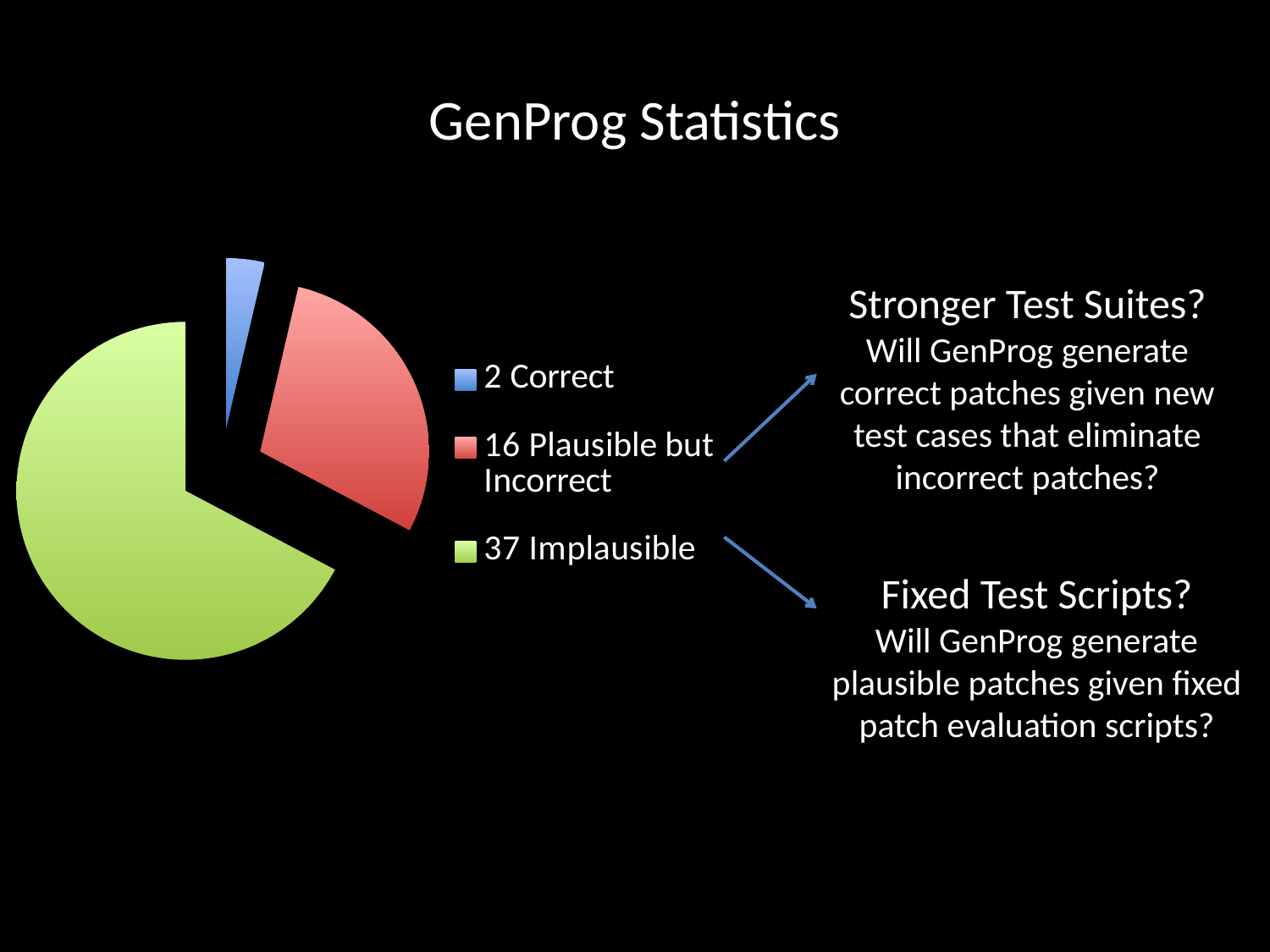
Which category has the largest slice of the pie chart? Implausible How many patches are labelled Plausible but Incorrect in the pie chart legend? 16 Which is larger, the number of Plausible but Incorrect patches or the number of Correct patches? Plausible but Incorrect How many entries does the legend of the pie chart list? 3 How many slices does the pie chart have? 3 What is the difference between the number of Implausible patches and the number of Plausible but Incorrect patches? 21 What kind of chart is shown on the slide? pie chart What is the total number of patches across all three slices of the pie chart? 55 What is the title of the slide containing the pie chart? GenProg Statistics How many patches are labelled Implausible in the pie chart legend? 37 How many patches are labelled Correct in the pie chart legend? 2 Which category has the smallest slice of the pie chart? Correct